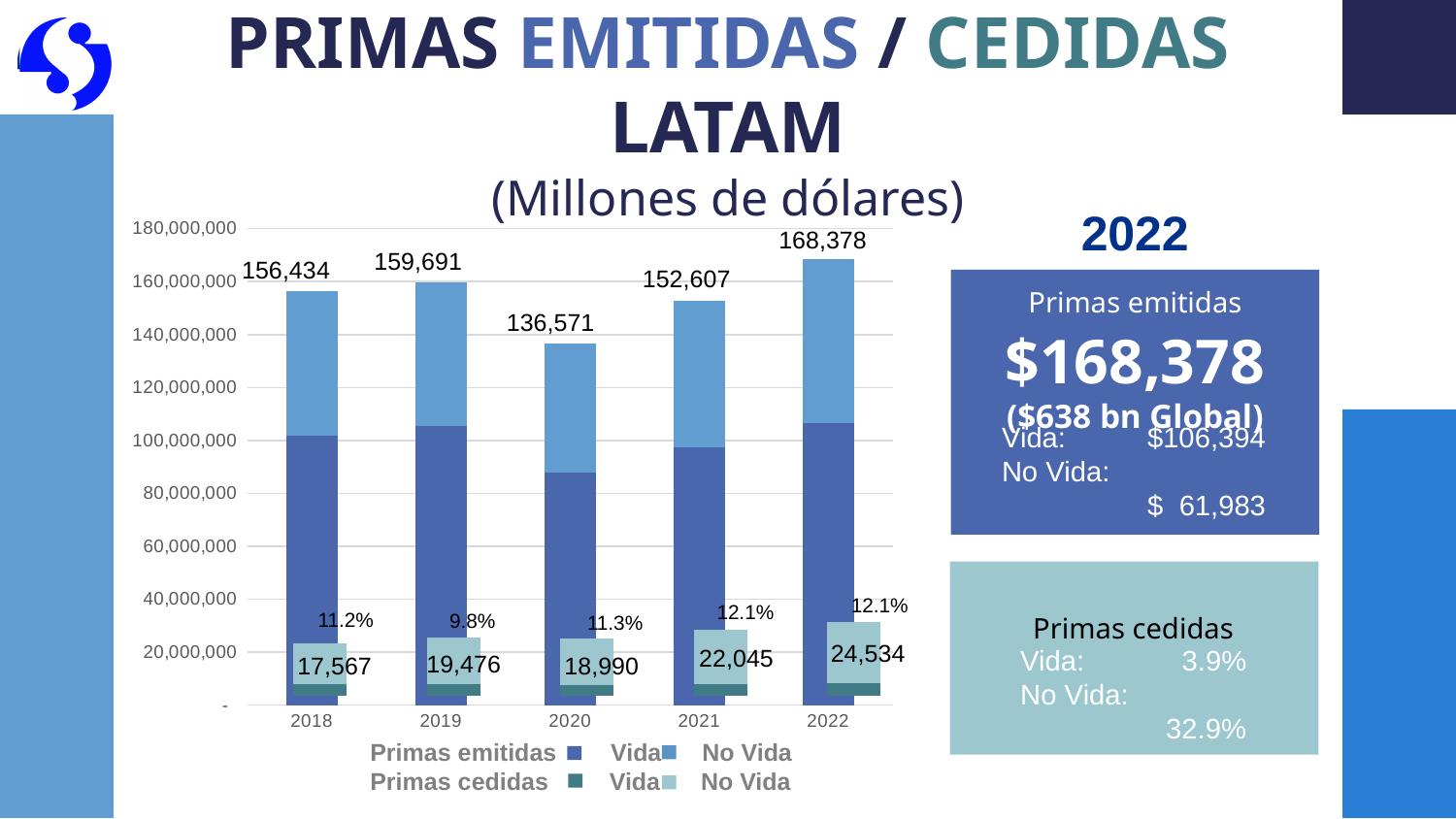
Which year has the highest total Primas emitidas? 2022 How many years are shown on the x axis of the chart? 5 What is the total Primas emitidas value labeled for 2022? 168,378 Which year has the lowest total Primas emitidas? 2020 What is the difference between the total Primas emitidas in 2022 and 2021? 15,771 Which is larger, the Primas cedidas value for 2019 or for 2020? 2019 Is the Primas emitidas Vida segment for 2020 greater or less than 100,000,000? less How many series does the chart legend list? 4 What kind of chart is shown on the slide? stacked bar chart What percentage is labeled above the Primas cedidas bar for 2019? 9.8% What unit is stated in the chart subtitle? Millones de dólares What is the Primas cedidas value labeled for 2018? 17,567